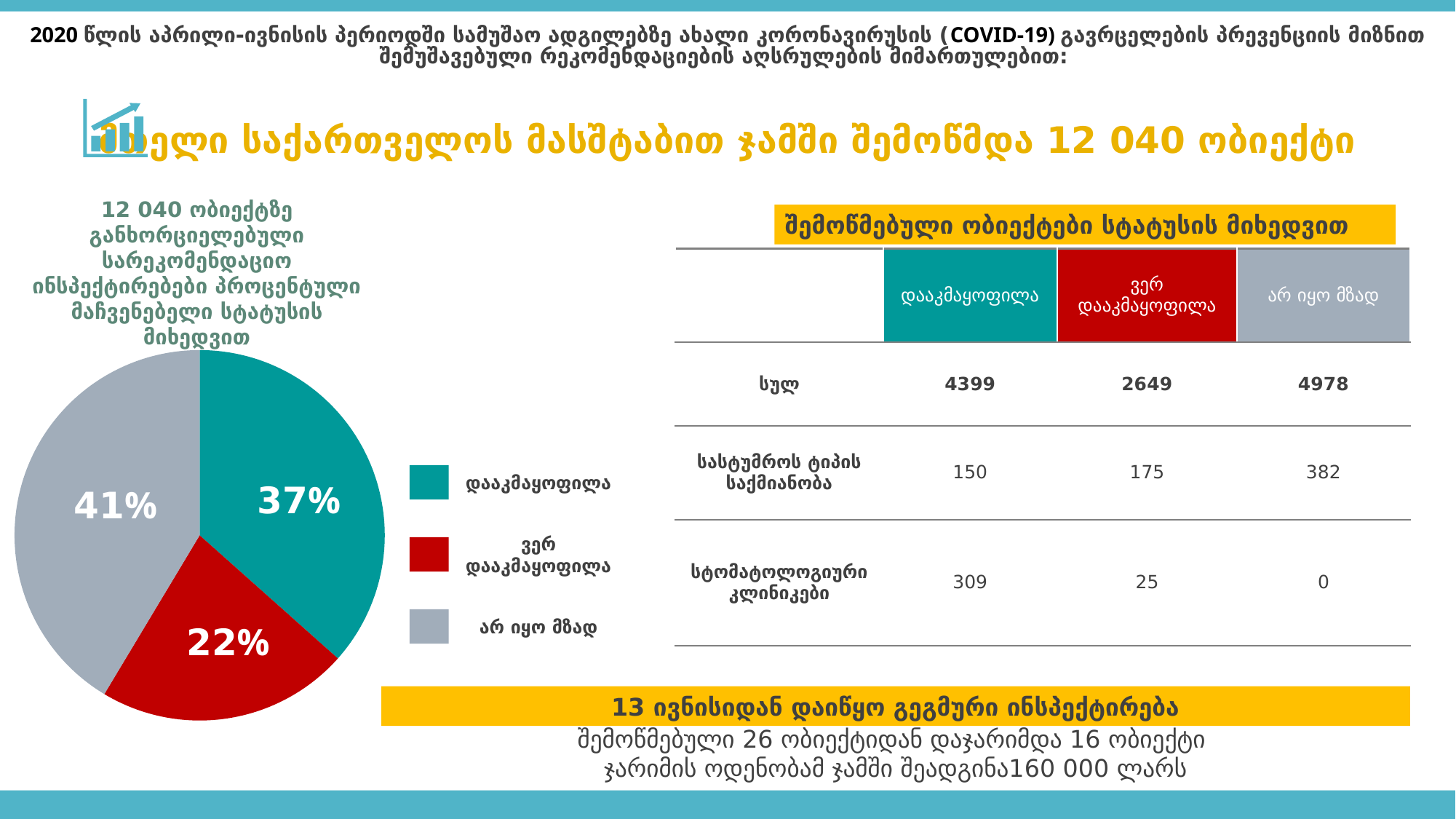
Which category has the smallest slice in the pie chart? ვერ დააკმაყოფილა In the pie chart, what share is shown for დააკმაყოფილა? 37% How many entries does the pie chart legend list? 3 What kind of chart is shown on the left of the slide? pie chart In the pie chart, what is the difference in percentage points between არ იყო მზად and დააკმაყოფილა? 4 In the pie chart, what share is shown for არ იყო მზად? 41% In the pie chart, what share is shown for ვერ დააკმაყოფილა? 22% How many slices does the pie chart have? 3 In the pie chart, what colour is the slice for დააკმაყოფილა? teal In the pie chart, what colour is the slice for ვერ დააკმაყოფილა? red Which category has the largest slice in the pie chart? არ იყო მზად In the pie chart, which is larger: დააკმაყოფილა or ვერ დააკმაყოფილა? დააკმაყოფილა